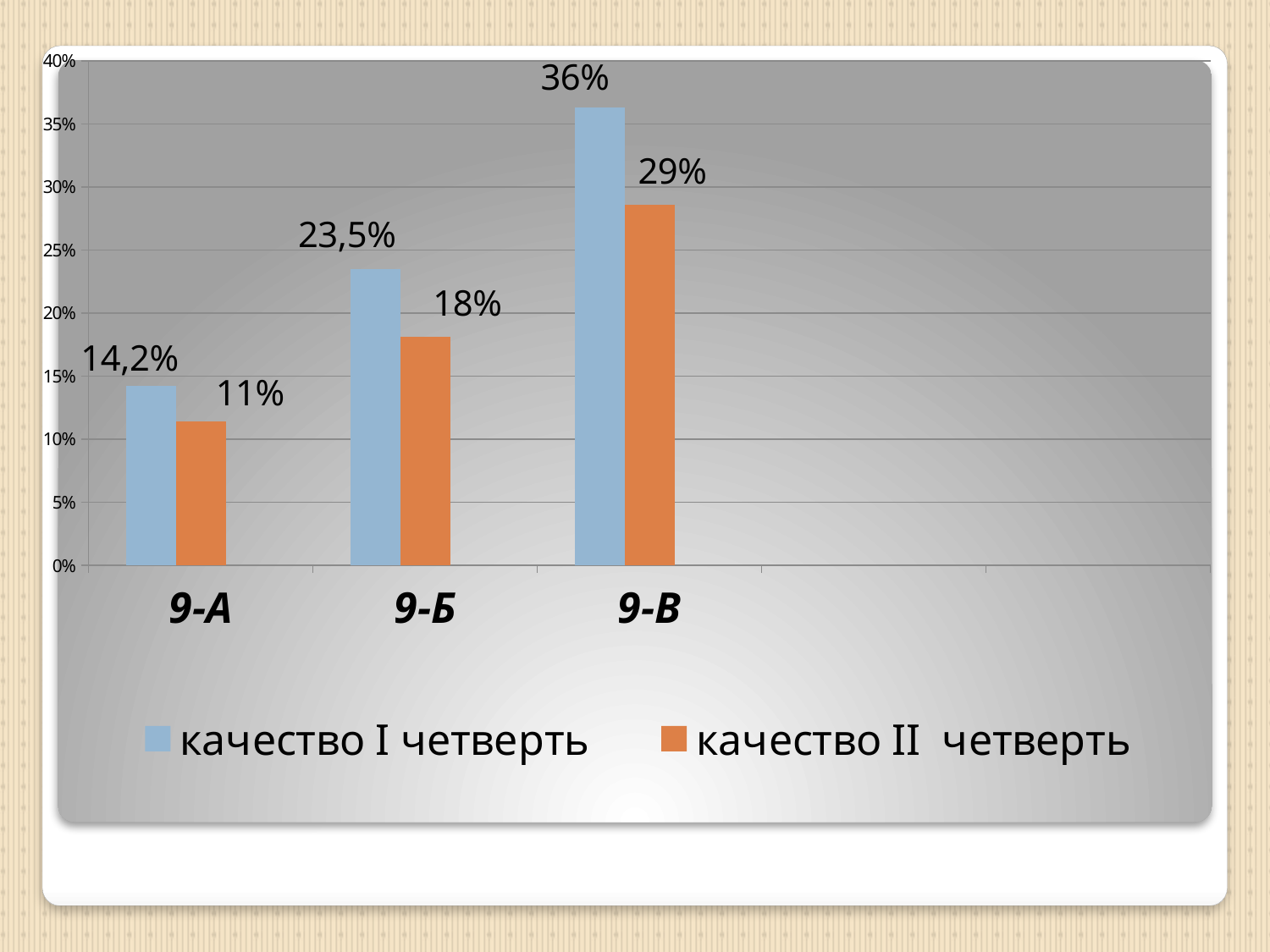
Do the values for качество II четверть rise or fall from 9-А to 9-В? rise What kind of chart is shown on the slide? bar chart What is the value for 9-В in the series качество I четверть? 36% What is the difference between the качество I четверть and качество II четверть values for 9-В? 7% How many series does the legend list? 2 Which category has the lowest value in the series качество II четверть? 9-А What is the value for 9-А in the series качество II четверть? 11% What is the value for 9-Б in the series качество II четверть? 18% Which is larger for 9-Б: качество I четверть or качество II четверть? качество I четверть Which category has the highest value in the series качество I четверть? 9-В What is the value for 9-А in the series качество I четверть? 14,2% How many categories are shown on the x axis? 3